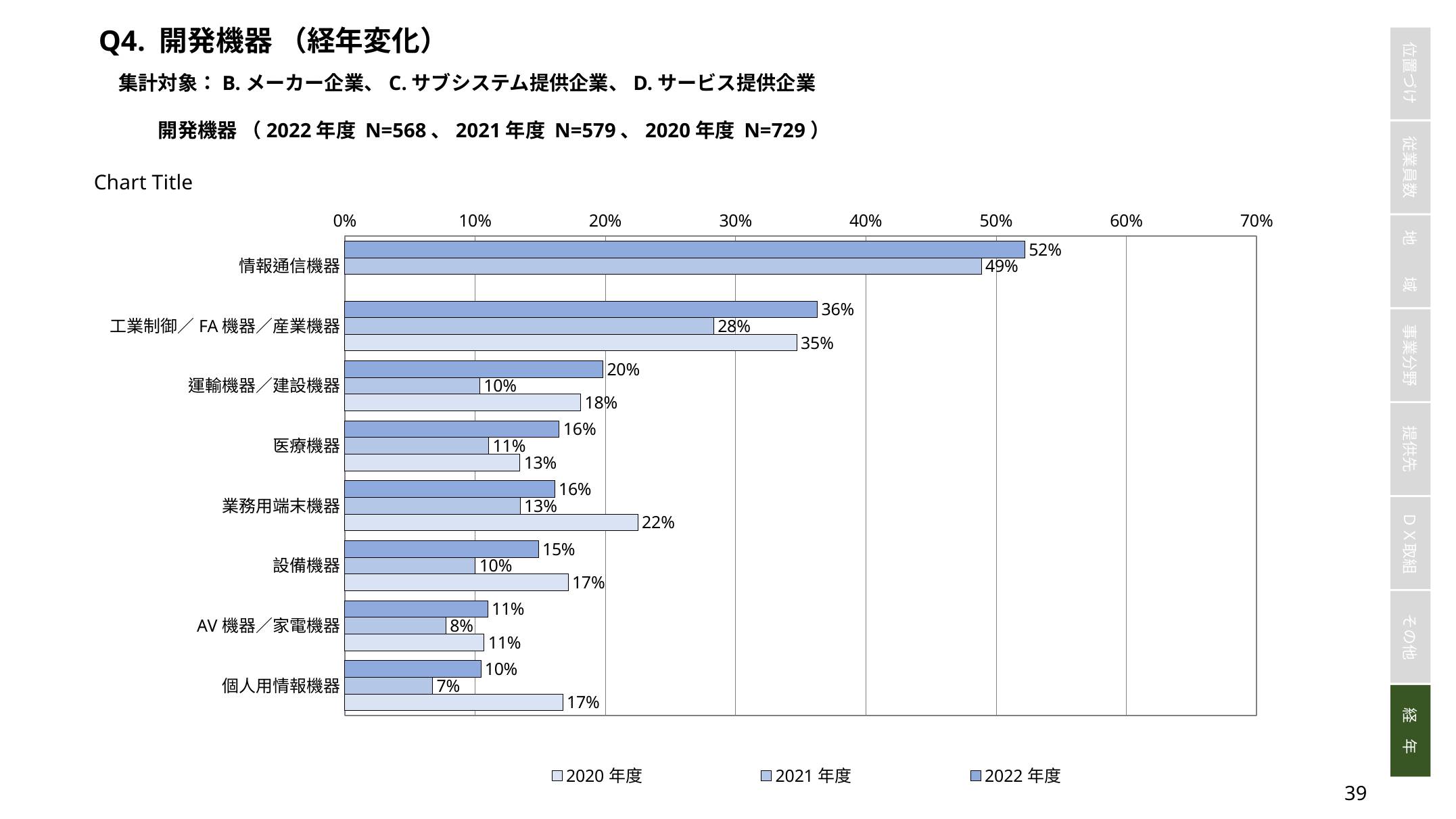
What type of chart is shown on the slide? bar chart What is the 2022年度 value for 情報通信機器? 52% Which category has the lowest 2021年度 value? 個人用情報機器 Is the 2021年度 value for 情報通信機器 greater or less than 40%? greater What is the 2020年度 value for 業務用端末機器? 22% What is the difference between the 2022年度 and 2021年度 values for 運輸機器／建設機器? 10% What is the 2021年度 value for 工業制御／FA機器／産業機器? 28% What is the difference between the 2020年度 and 2021年度 values for 個人用情報機器? 10% How many series does the legend list? 3 How many device categories are plotted on the chart? 8 Which category has the highest 2022年度 value? 情報通信機器 Which is larger for 設備機器: the 2020年度 value or the 2022年度 value? 2020年度